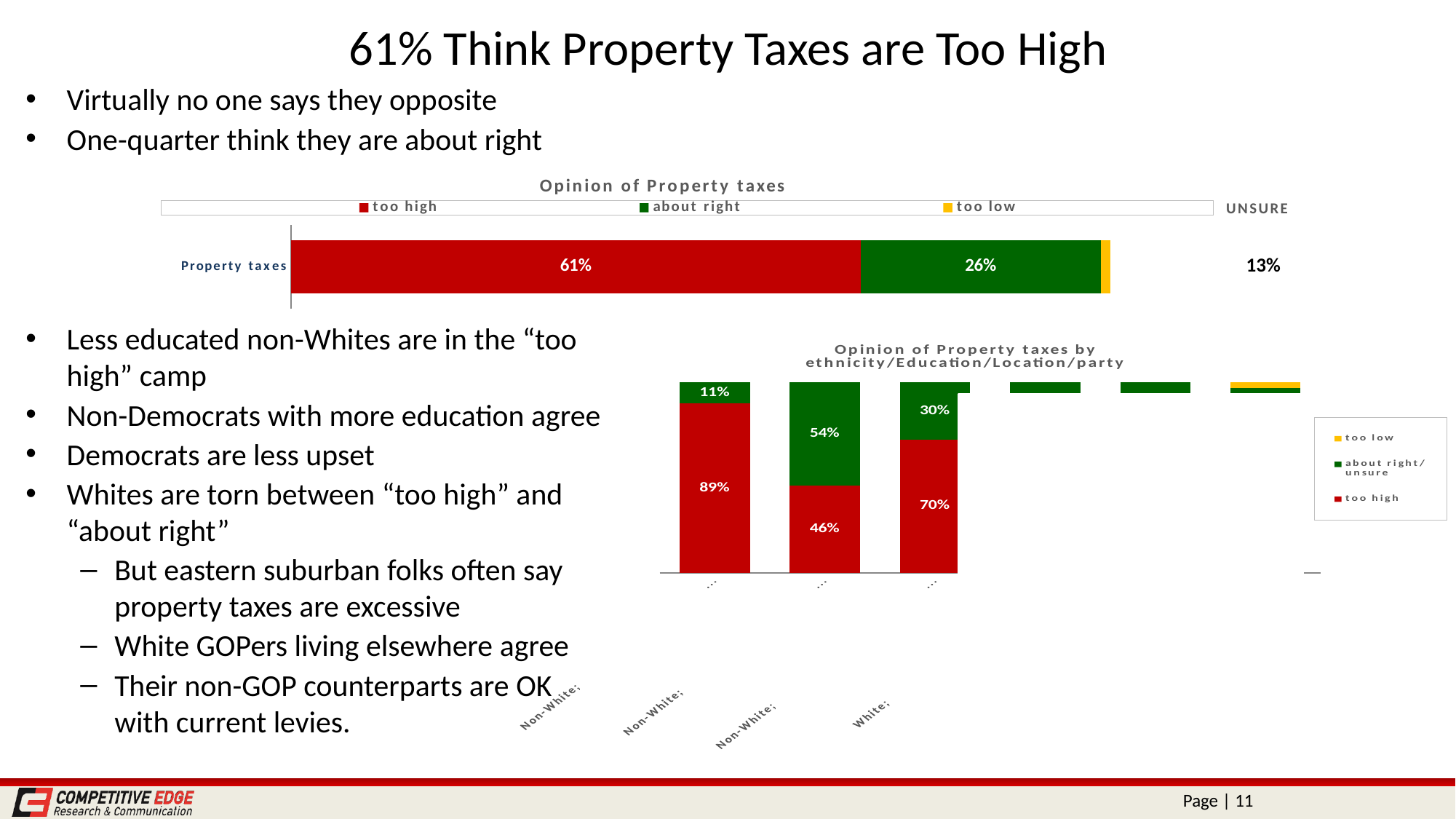
In the 'Opinion of Property taxes by ethnicity/Education/Location/party' chart, which of the three labelled bars has the lowest 'too high' value? The second bar from the left (46%) In the 'Opinion of Property taxes' chart, what percentage are unsure? 13% In the 'Opinion of Property taxes by ethnicity/Education/Location/party' chart, what is the 'about right/unsure' value for the second bar from the left? 54% How many entries does the legend of the 'Opinion of Property taxes by ethnicity/Education/Location/party' chart list? 3 How many entries does the legend box of the 'Opinion of Property taxes' chart list? 3 What kind of chart is the 'Opinion of Property taxes' chart? Stacked bar chart In the 'Opinion of Property taxes' chart, which is larger, the 'too high' share or the 'about right' share? too high In the 'Opinion of Property taxes by ethnicity/Education/Location/party' chart, what is the 'too high' value for the leftmost bar? 89% In the 'Opinion of Property taxes' chart, what percentage say property taxes are about right? 26% In the 'Opinion of Property taxes' chart, what percentage say property taxes are too high? 61% In the 'Opinion of Property taxes' chart, which response has the smallest share of the bar? too low In the 'Opinion of Property taxes' chart, what is the difference between the 'too high' and 'about right' shares? 35%